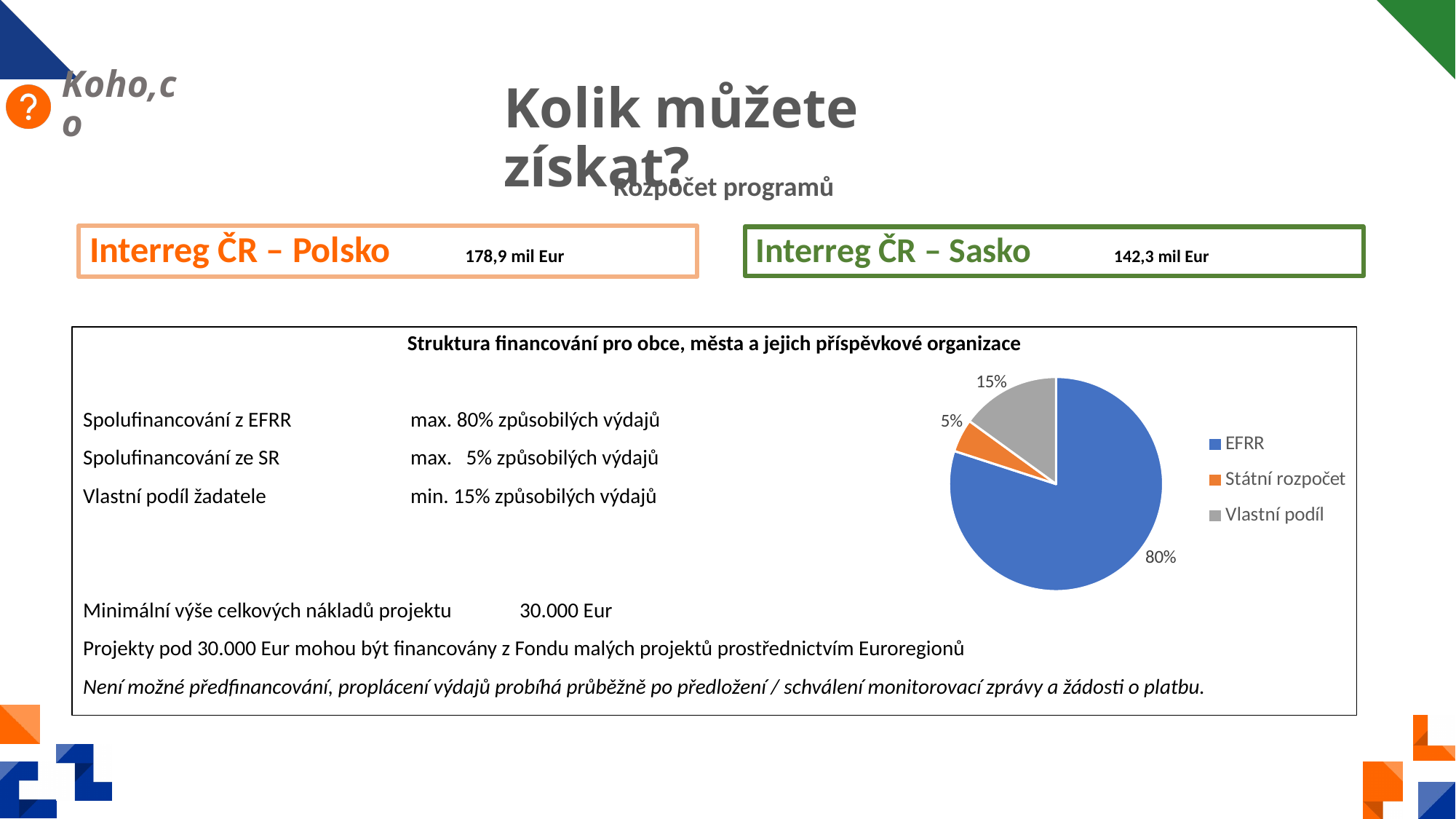
Which slice of the pie chart is the smallest? Státní rozpočet What share of the pie chart does EFRR represent? 80% How many entries does the pie chart legend list? 3 What is the difference in percentage points between the EFRR slice and the Vlastní podíl slice? 65 Which is larger in the pie chart, Vlastní podíl or Státní rozpočet? Vlastní podíl How many slices does the pie chart have? 3 What share of the pie chart does Vlastní podíl represent? 15% What kind of chart is shown on the slide? pie chart What colour is the Státní rozpočet slice in the pie chart? orange What colour is the EFRR slice in the pie chart? blue What share of the pie chart does Státní rozpočet represent? 5% Which slice of the pie chart is the largest? EFRR